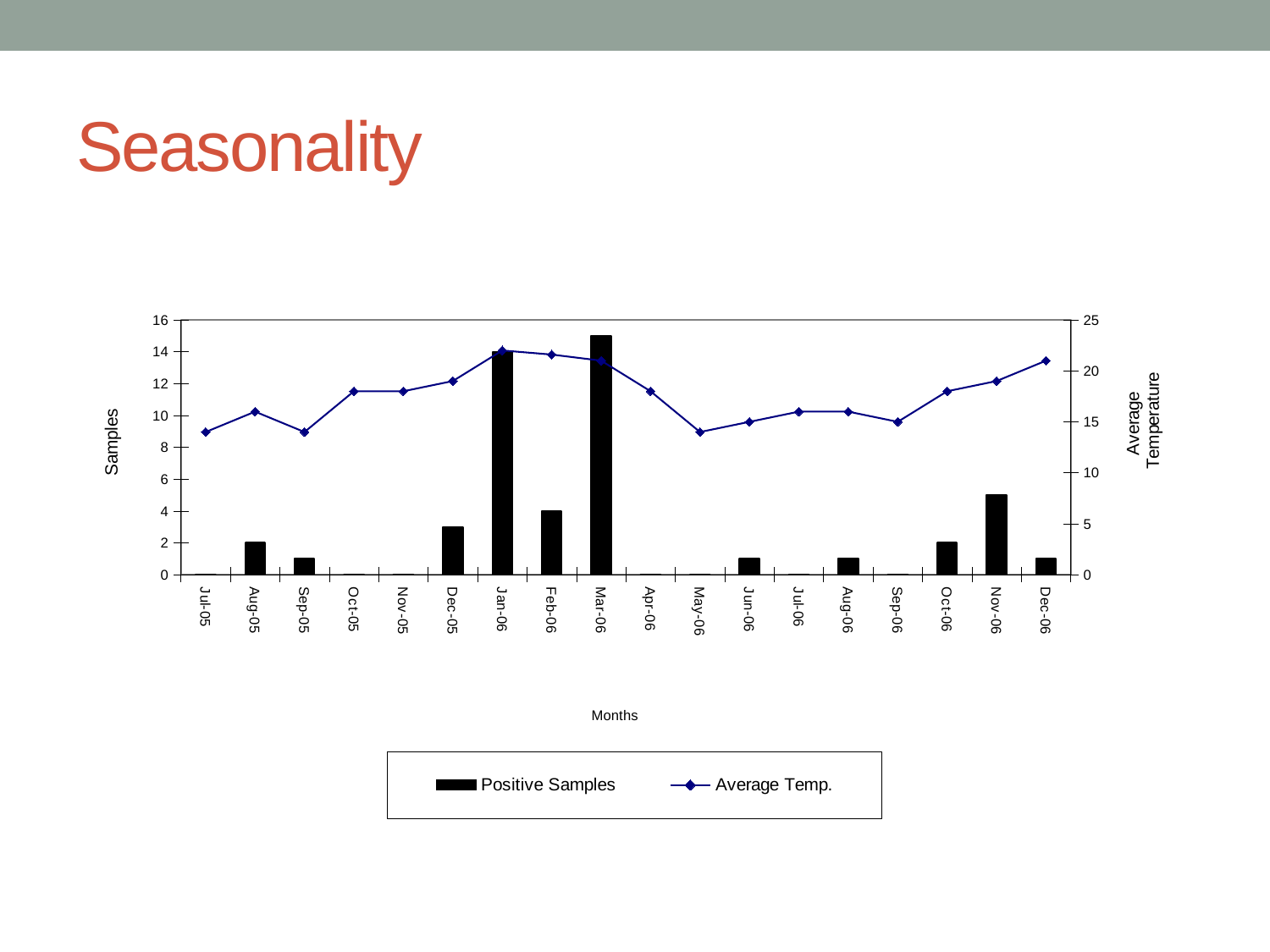
How many Positive Samples are shown for Feb-06? 4 Which month has more Positive Samples, Jan-06 or Nov-06? Jan-06 What is the title of the slide containing the chart? Seasonality How many months are shown along the x axis? 18 How many series does the legend list? 2 What is the difference in Positive Samples between Jan-06 and Feb-06? 10 Which month has the highest number of Positive Samples? Mar-06 How many Positive Samples are shown for Aug-05? 2 Is the Average Temp. value for May-06 greater or less than 15? less What kind of chart is shown on the slide? A combination bar and line chart How many Positive Samples are shown for Jan-06? 14 Is the Average Temp. value for Jan-06 greater or less than 20? greater